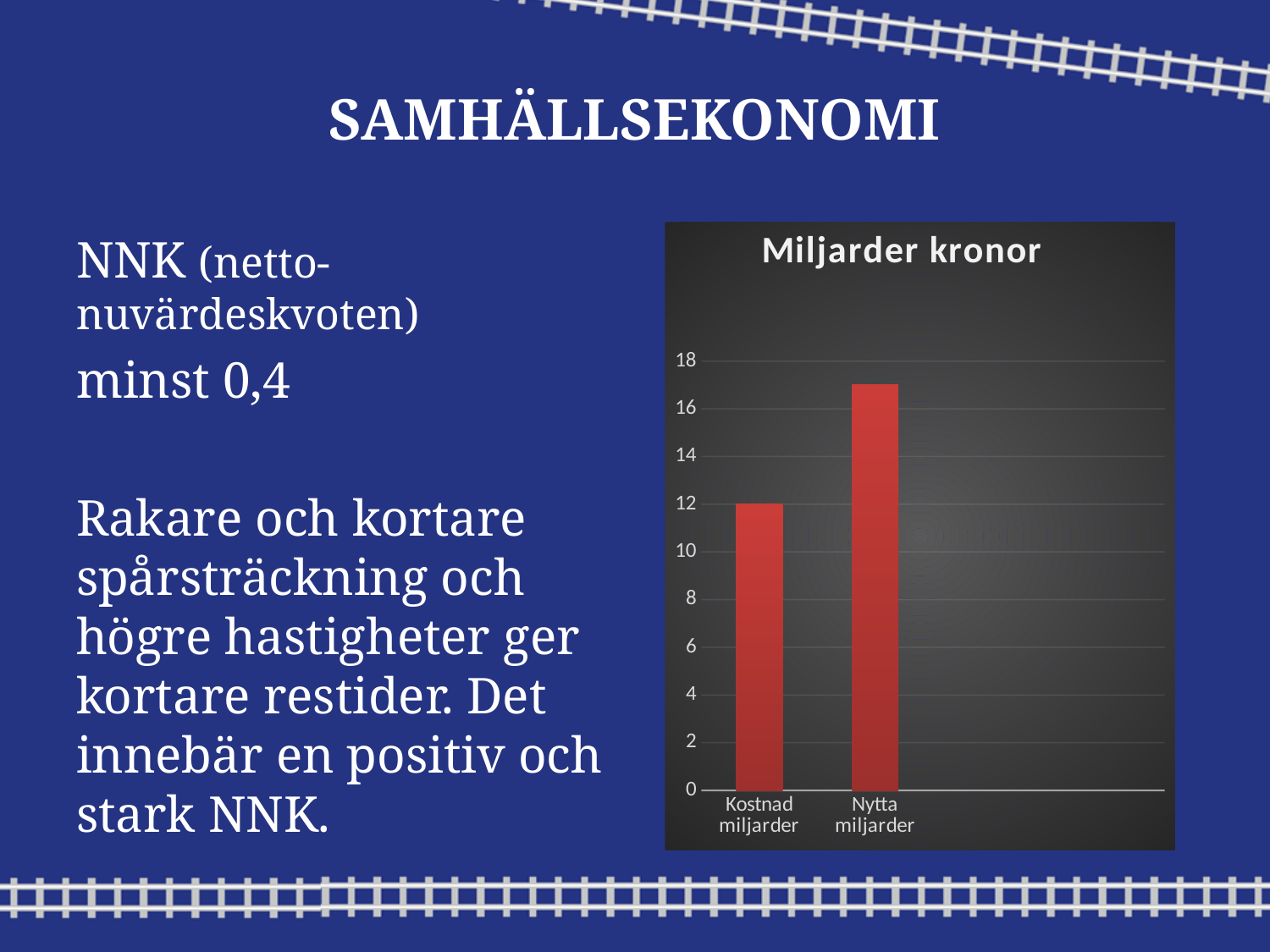
Which category has the lowest bar in the chart? Kostnad miljarder Is the value for Kostnad miljarder greater or less than 10? greater Is the value for Kostnad miljarder greater or less than 14? less What is the highest value shown on the chart's y axis? 18 What is the title of the chart? Miljarder kronor How many bars are plotted in the chart? 2 What kind of chart is shown on the slide? bar chart Is the value for Nytta miljarder greater or less than 16? greater What value does the bar for Kostnad miljarder reach on the y axis? 12 Which category has the highest bar in the chart? Nytta miljarder Which is larger, the bar for Kostnad miljarder or the bar for Nytta miljarder? Nytta miljarder